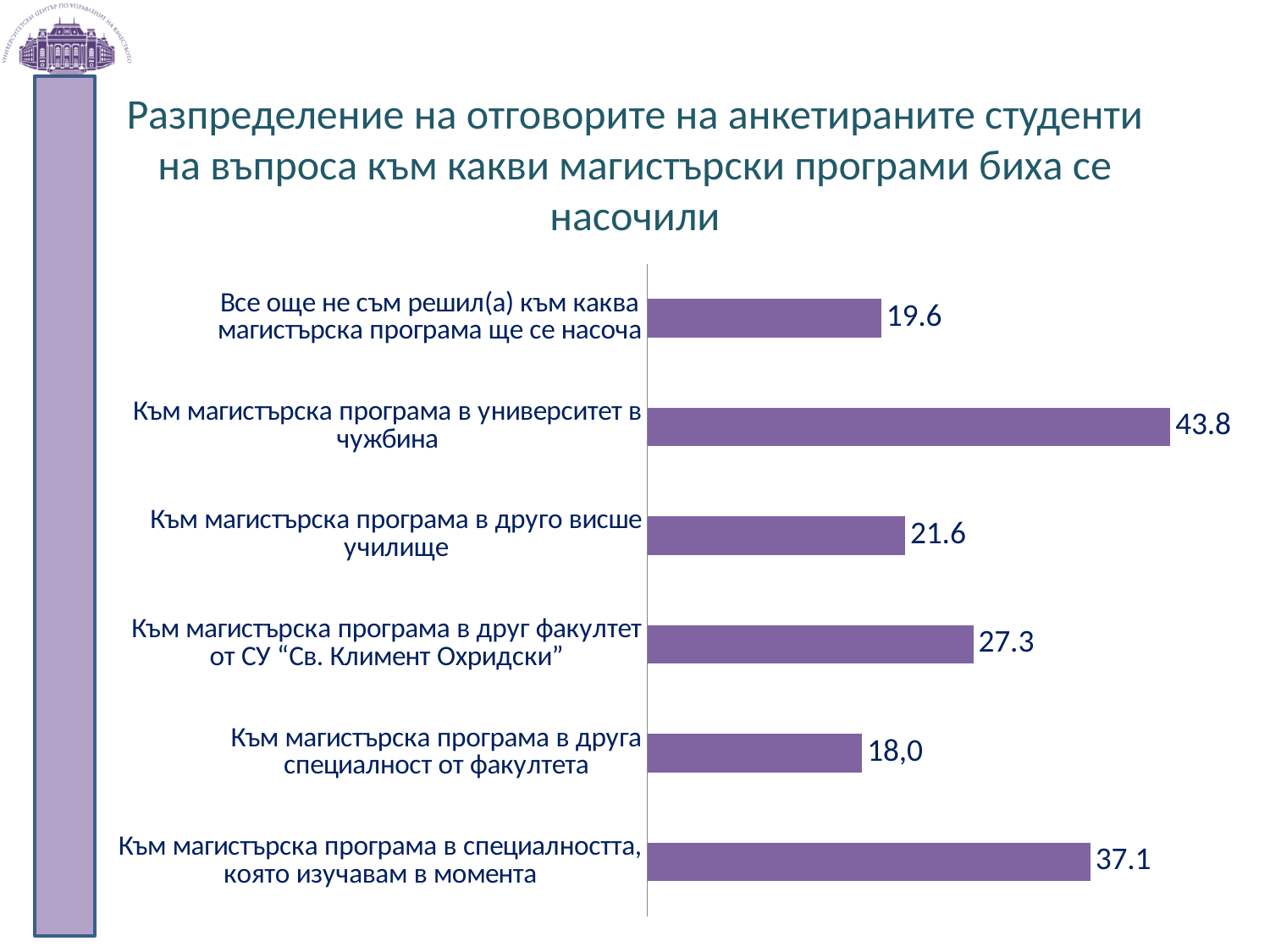
Which is larger: the value for "Към магистърска програма в друго висше училище" or for "Все още не съм решил(а) към каква магистърска програма ще се насоча"? Към магистърска програма в друго висше училище What is the value for "Към магистърска програма в друга специалност от факултета"? 18,0 What is the difference between the values for "Към магистърска програма в университет в чужбина" and "Към магистърска програма в специалността, която изучавам в момента"? 6.7 What kind of chart is shown on the slide? Bar chart What is the value for "Към магистърска програма в специалността, която изучавам в момента"? 37.1 Which category has the highest value? Към магистърска програма в университет в чужбина What is the value for "Към магистърска програма в университет в чужбина"? 43.8 What is the value for "Все още не съм решил(а) към каква магистърска програма ще се насоча"? 19.6 What is the difference between the values for "Към магистърска програма в друг факултет от СУ “Св. Климент Охридски”" and "Към магистърска програма в друго висше училище"? 5.7 Which category has the lowest value? Към магистърска програма в друга специалност от факултета What colour are the bars in the chart? Purple How many categories are shown in the chart? 6